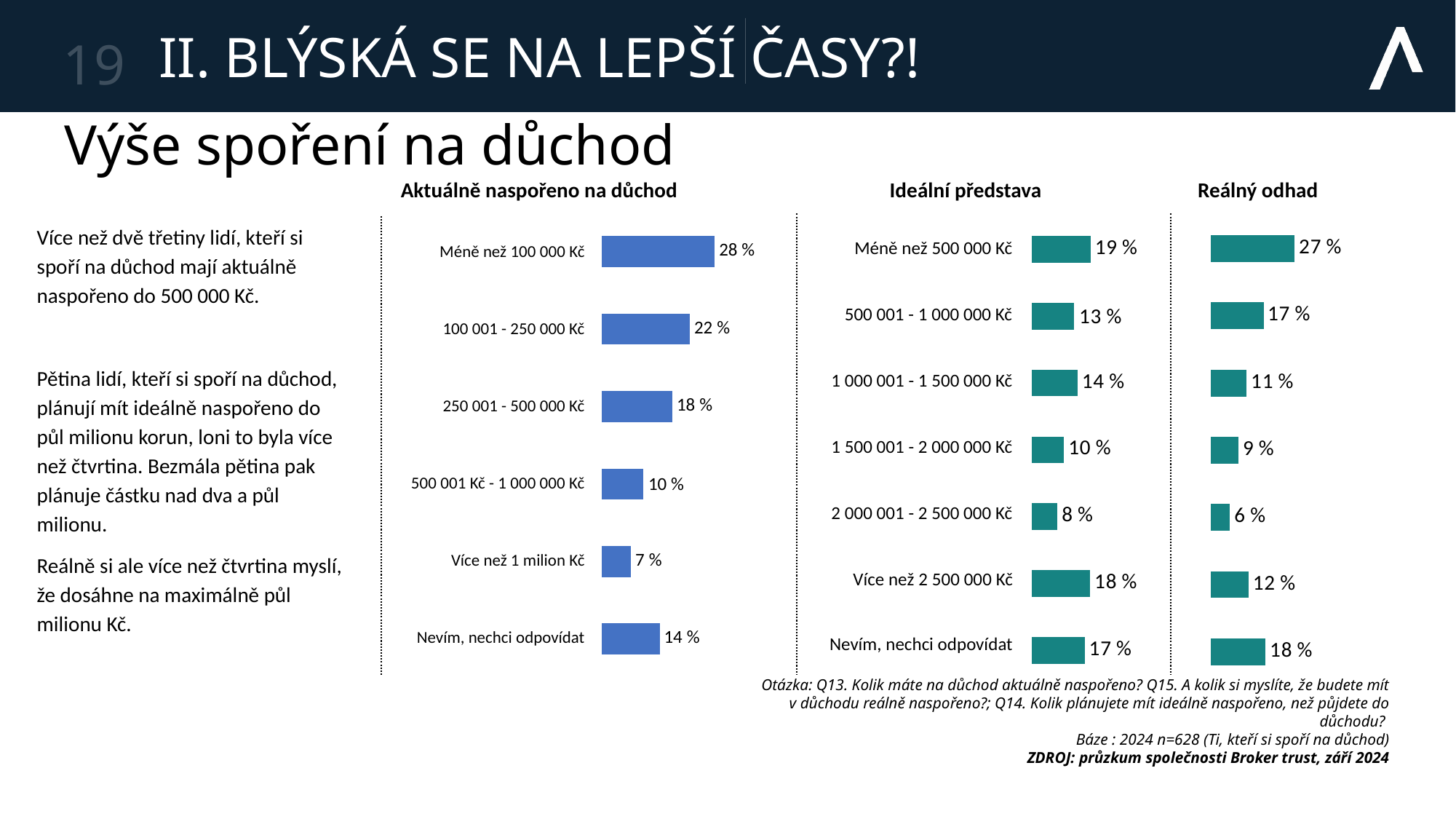
In the 'Reálný odhad' chart, which category has the highest value? Méně než 500 000 Kč What kind of chart is 'Aktuálně naspořeno na důchod'? Bar chart How many categories does the 'Aktuálně naspořeno na důchod' chart show? 6 In the 'Aktuálně naspořeno na důchod' chart, which category has the lowest value? Více než 1 milion Kč For 'Více než 2 500 000 Kč', which is larger: the value in the 'Ideální představa' chart or the value in the 'Reálný odhad' chart? Ideální představa In the 'Ideální představa' chart, what is the value for 'Více než 2 500 000 Kč'? 18 % In the 'Ideální představa' chart, which category has the highest value? Méně než 500 000 Kč In the 'Reálný odhad' chart, what is the value for '500 001 - 1 000 000 Kč'? 17 % In the 'Aktuálně naspořeno na důchod' chart, what is the difference between '100 001 - 250 000 Kč' and '250 001 - 500 000 Kč'? 4 % In the 'Reálný odhad' chart, what is the difference between 'Méně než 500 000 Kč' and 'Nevím, nechci odpovídat'? 9 % In the 'Ideální představa' chart, which category has the lowest value? 2 000 001 - 2 500 000 Kč In the 'Aktuálně naspořeno na důchod' chart, what is the value for 'Méně než 100 000 Kč'? 28 %